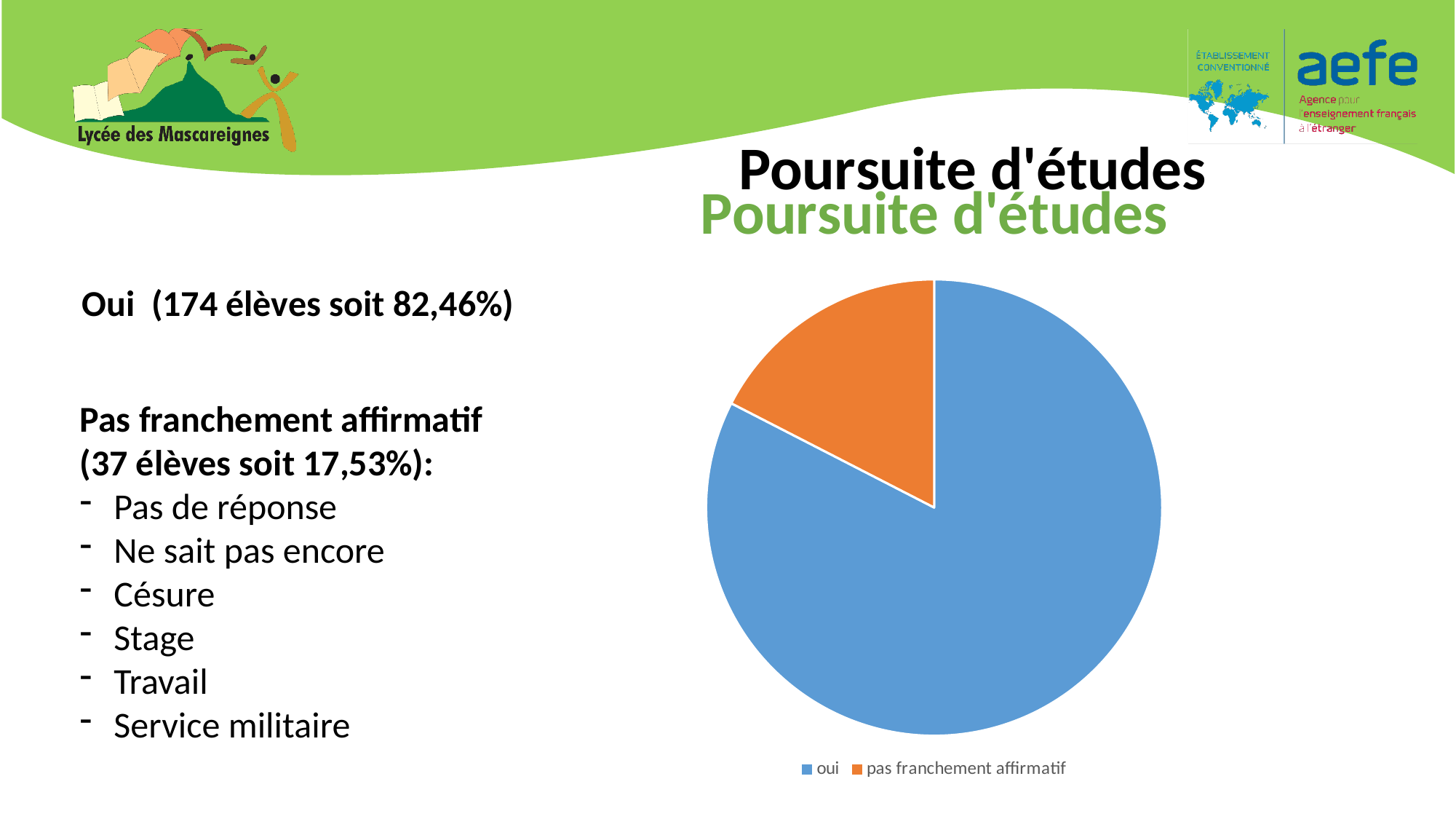
Which slice of the pie chart is the largest? oui Which is larger in the pie chart, the 'oui' slice or the 'pas franchement affirmatif' slice? oui What kind of chart is shown on the slide? pie chart Which slice of the pie chart is the smallest? pas franchement affirmatif What is the title shown above the pie chart? Poursuite d'études According to the slide, how many students answered 'oui'? 174 élèves How many entries does the legend of the pie chart list? 2 How many slices does the pie chart have? 2 According to the slide, what share of the pie does the 'pas franchement affirmatif' slice represent? 17,53% According to the slide, how many students are in the 'pas franchement affirmatif' group? 37 élèves According to the slide, what share of the pie does the 'oui' slice represent? 82,46% What colour is the 'oui' slice in the pie chart? blue